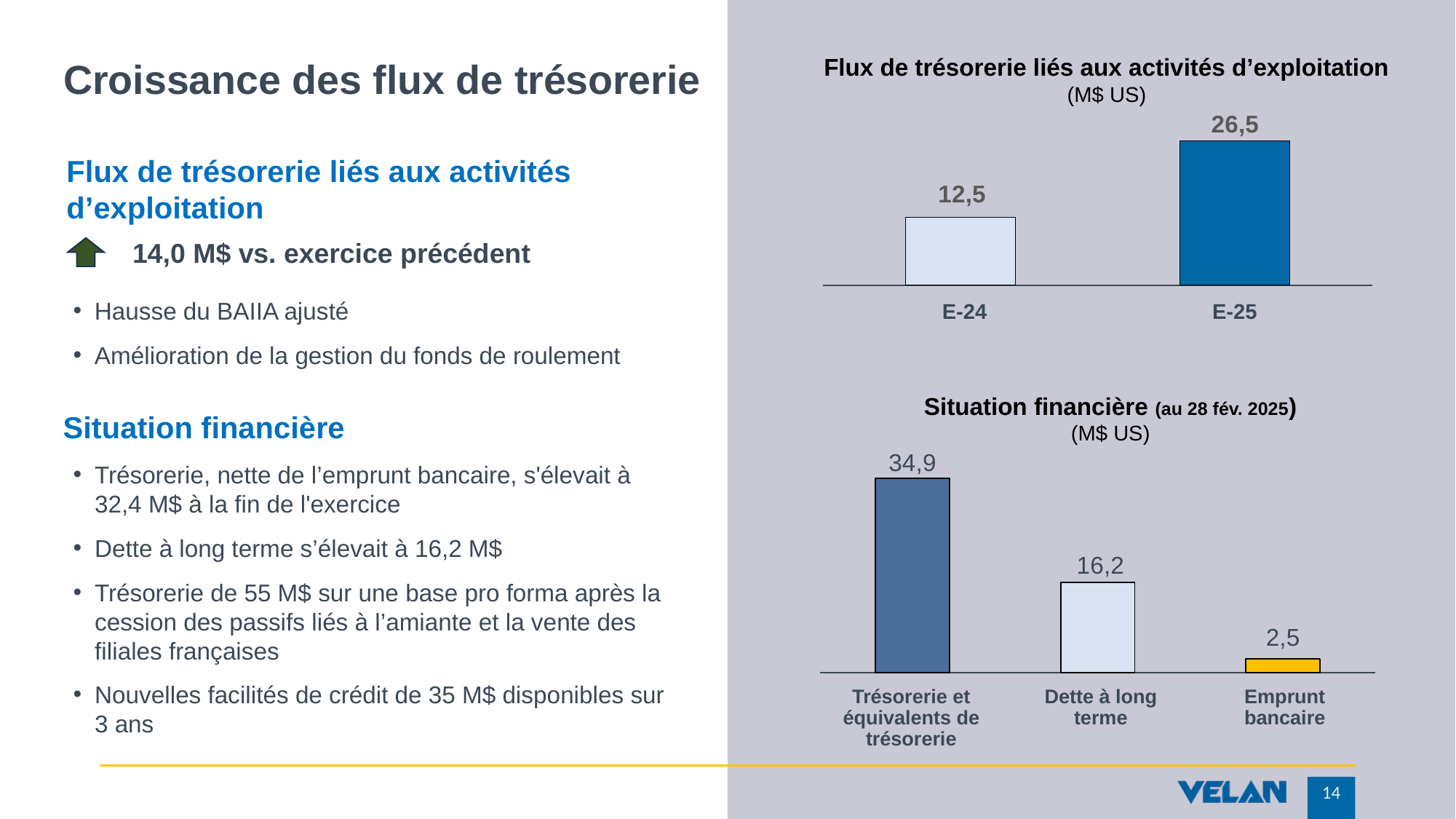
In the 'Situation financière' chart, which category has the lowest value? Emprunt bancaire In the 'Flux de trésorerie liés aux activités d'exploitation' chart, what is the value for E-25? 26,5 In the 'Situation financière' chart, what is the value for 'Trésorerie et équivalents de trésorerie'? 34,9 In the 'Flux de trésorerie liés aux activités d'exploitation' chart, what is the difference between E-25 and E-24? 14,0 In the 'Flux de trésorerie liés aux activités d'exploitation' chart, how many bars are plotted? 2 In the 'Flux de trésorerie liés aux activités d'exploitation' chart, what is the value for E-24? 12,5 In the 'Situation financière' chart, what unit is shown under the title? M$ US What kind of chart is the 'Flux de trésorerie liés aux activités d'exploitation' chart? Bar chart In the 'Flux de trésorerie liés aux activités d'exploitation' chart, which year has the higher value? E-25 In the 'Situation financière' chart, what is the value for 'Emprunt bancaire'? 2,5 In the 'Situation financière' chart, what is the difference between 'Trésorerie et équivalents de trésorerie' and 'Dette à long terme'? 18,7 In the 'Situation financière' chart, what is the value for 'Dette à long terme'? 16,2